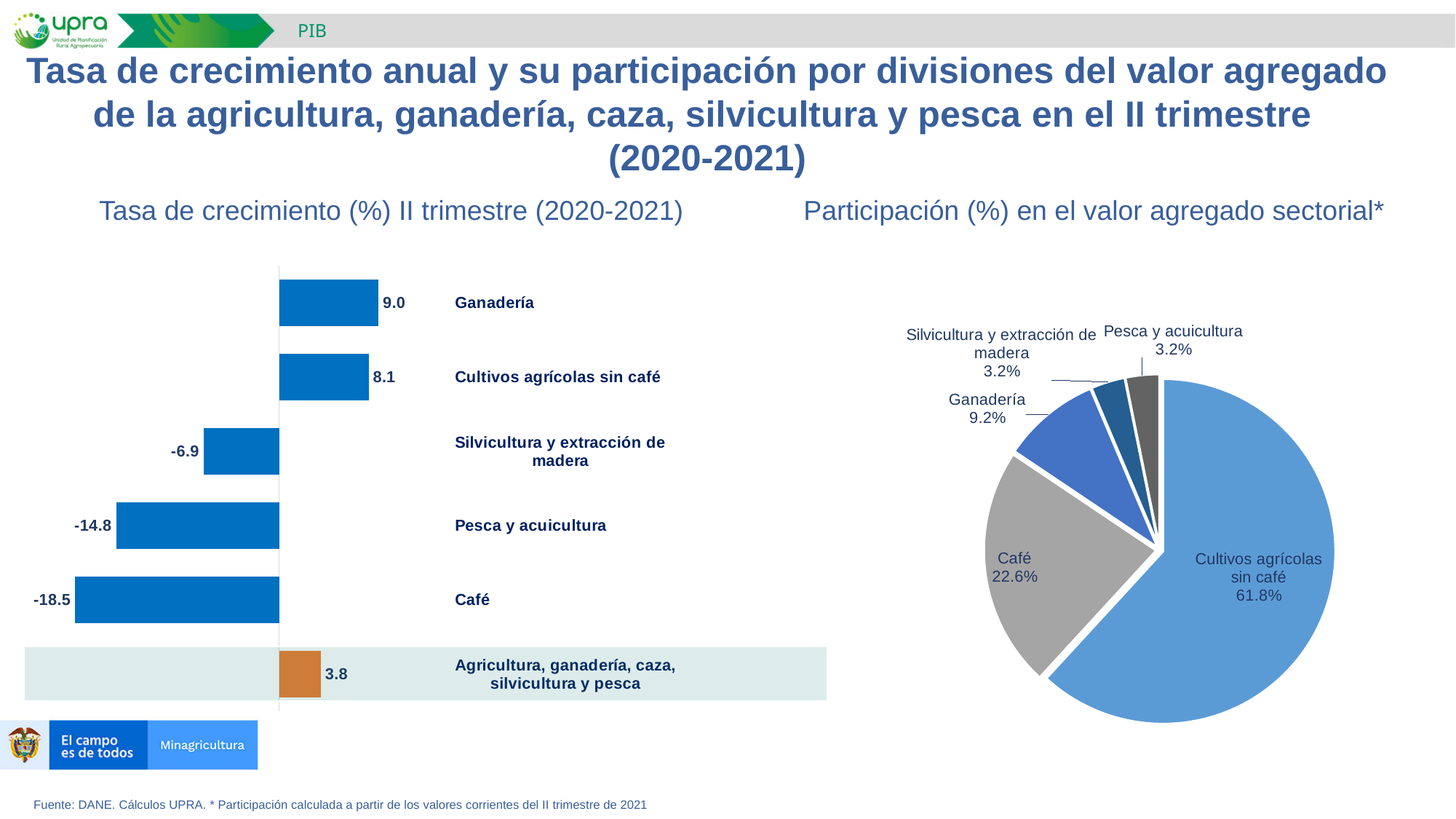
In the 'Participación (%) en el valor agregado sectorial*' chart, which slice is the largest? Cultivos agrícolas sin café In the 'Participación (%) en el valor agregado sectorial*' chart, what share does Café have? 22.6% In the 'Tasa de crecimiento (%) II trimestre (2020-2021)' chart, what is the value for Pesca y acuicultura? -14.8 In the 'Tasa de crecimiento (%) II trimestre (2020-2021)' chart, what is the difference between the values for Ganadería and Cultivos agrícolas sin café? 0.9 In the 'Tasa de crecimiento (%) II trimestre (2020-2021)' chart, what is the value for Ganadería? 9.0 What kind of chart is the 'Tasa de crecimiento (%) II trimestre (2020-2021)' chart? Bar chart What kind of chart is the 'Participación (%) en el valor agregado sectorial*' chart? Pie chart In the 'Tasa de crecimiento (%) II trimestre (2020-2021)' chart, which category has the highest value? Ganadería In the 'Participación (%) en el valor agregado sectorial*' chart, is the share for Ganadería larger or smaller than the share for Café? Smaller In the 'Tasa de crecimiento (%) II trimestre (2020-2021)' chart, what is the value for Café? -18.5 In the 'Tasa de crecimiento (%) II trimestre (2020-2021)' chart, which category has the lowest value? Café In the 'Tasa de crecimiento (%) II trimestre (2020-2021)' chart, how many categories are shown? 6